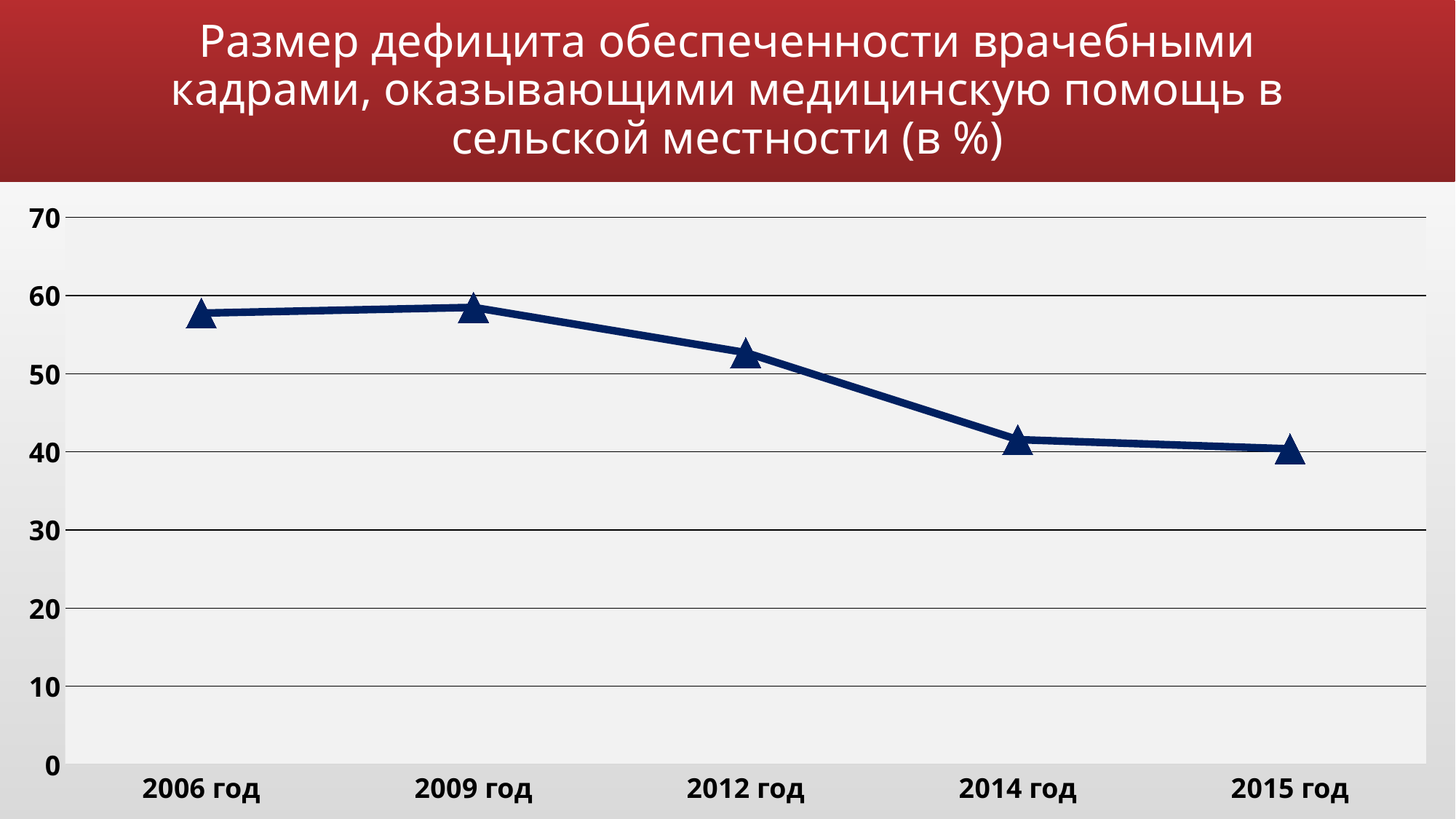
Which has the larger value, 2012 год or 2015 год? 2012 год How many years are plotted on the x axis of the chart? 5 What is the first year shown on the x axis of the chart? 2006 год What is the highest value shown on the vertical axis of the chart? 70 Do the values in the chart generally rise or fall from 2006 год to 2015 год? fall Is the value for 2006 год greater or less than 50? greater Which has the larger value, 2006 год or 2014 год? 2006 год Is the value for 2012 год greater or less than 60? less Is the value for 2009 год greater or less than 60? less What kind of chart is shown on the slide? line chart